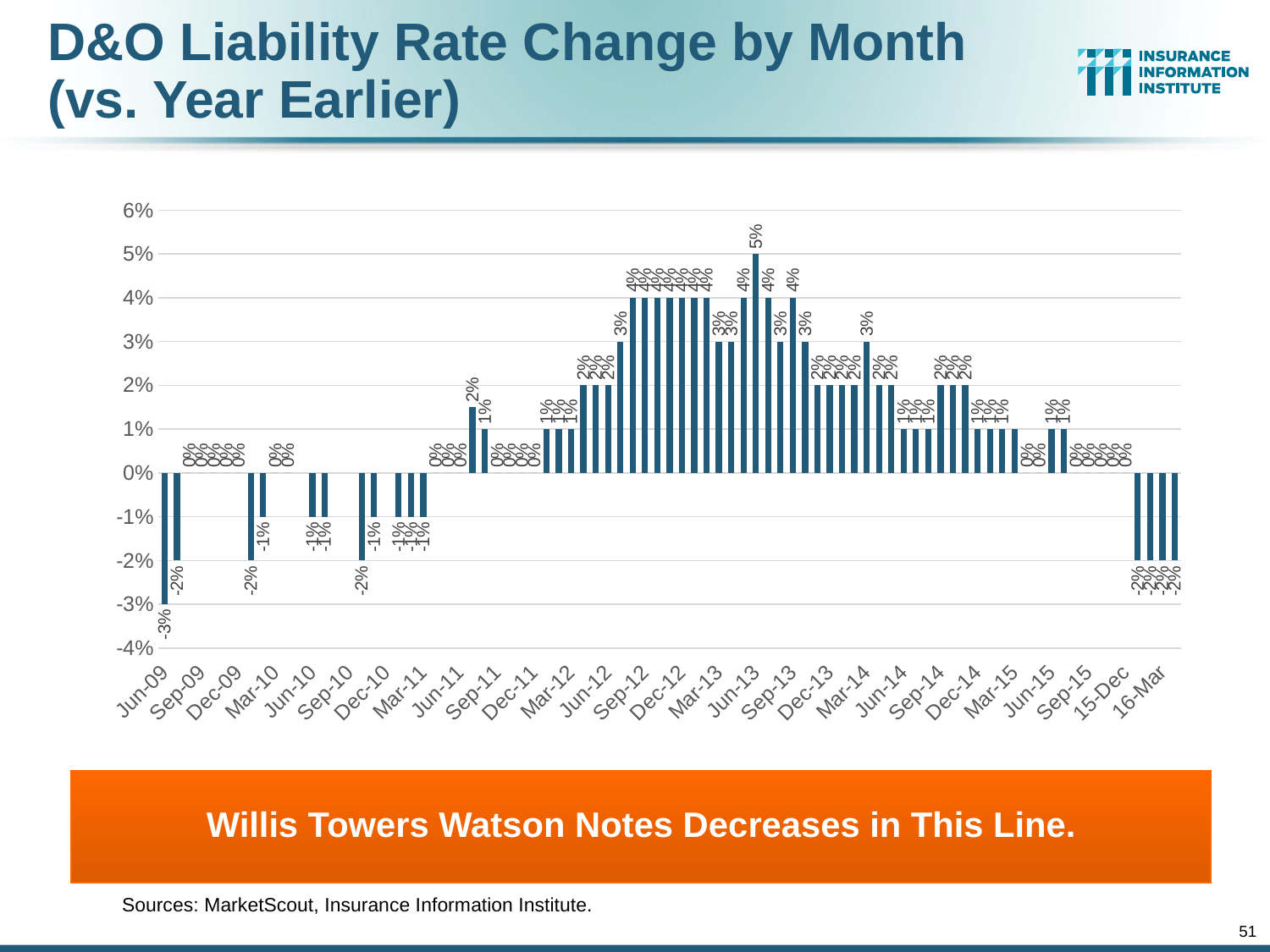
What is the D&O liability rate change for Jun-09? -3% What is the title of the chart on the slide? D&O Liability Rate Change by Month (vs. Year Earlier) What is the difference between the highest value (5%) and the lowest value (-3%) on the chart? 8 percentage points What is the lowest value shown on the chart? -3% Which is larger, the value for Jun-13 or the value for Jun-09? Jun-13 What is the D&O liability rate change for Jun-13? 5% What is the highest value shown on the chart? 5% What is the D&O liability rate change for 16-Mar? -2% What kind of chart is shown on the slide? bar chart Is the value for Jun-09 greater or less than 0%? less Do the values generally rise or fall from Jun-09 to Jun-13? rise What is the highest value shown on the vertical axis? 6%